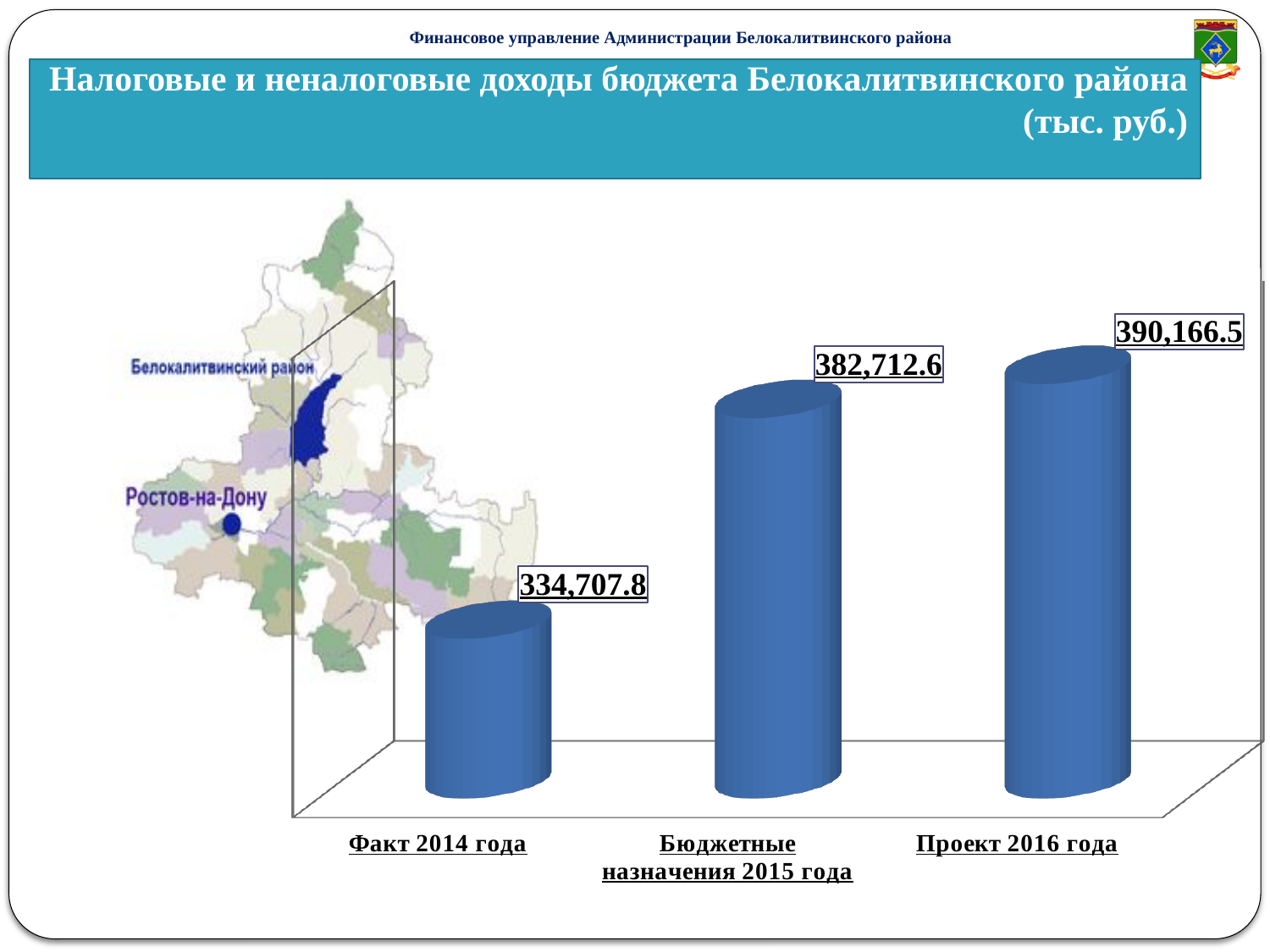
What is the value for Факт 2014 года? 334,707.8 What is the difference between the values for Проект 2016 года and Факт 2014 года? 55,458.7 What is the value for Проект 2016 года? 390,166.5 Which category has the highest value? Проект 2016 года What is the value for Бюджетные назначения 2015 года? 382,712.6 Which category has the lowest value? Факт 2014 года How many categories are shown in the chart? 3 Which is larger, the value for Проект 2016 года or the value for Бюджетные назначения 2015 года? Проект 2016 года What kind of chart is shown on the slide? Bar chart What is the difference between the values for Проект 2016 года and Бюджетные назначения 2015 года? 7,453.9 What is the difference between the values for Бюджетные назначения 2015 года and Факт 2014 года? 48,004.8 Do the values rise or fall from Факт 2014 года to Проект 2016 года? Rise